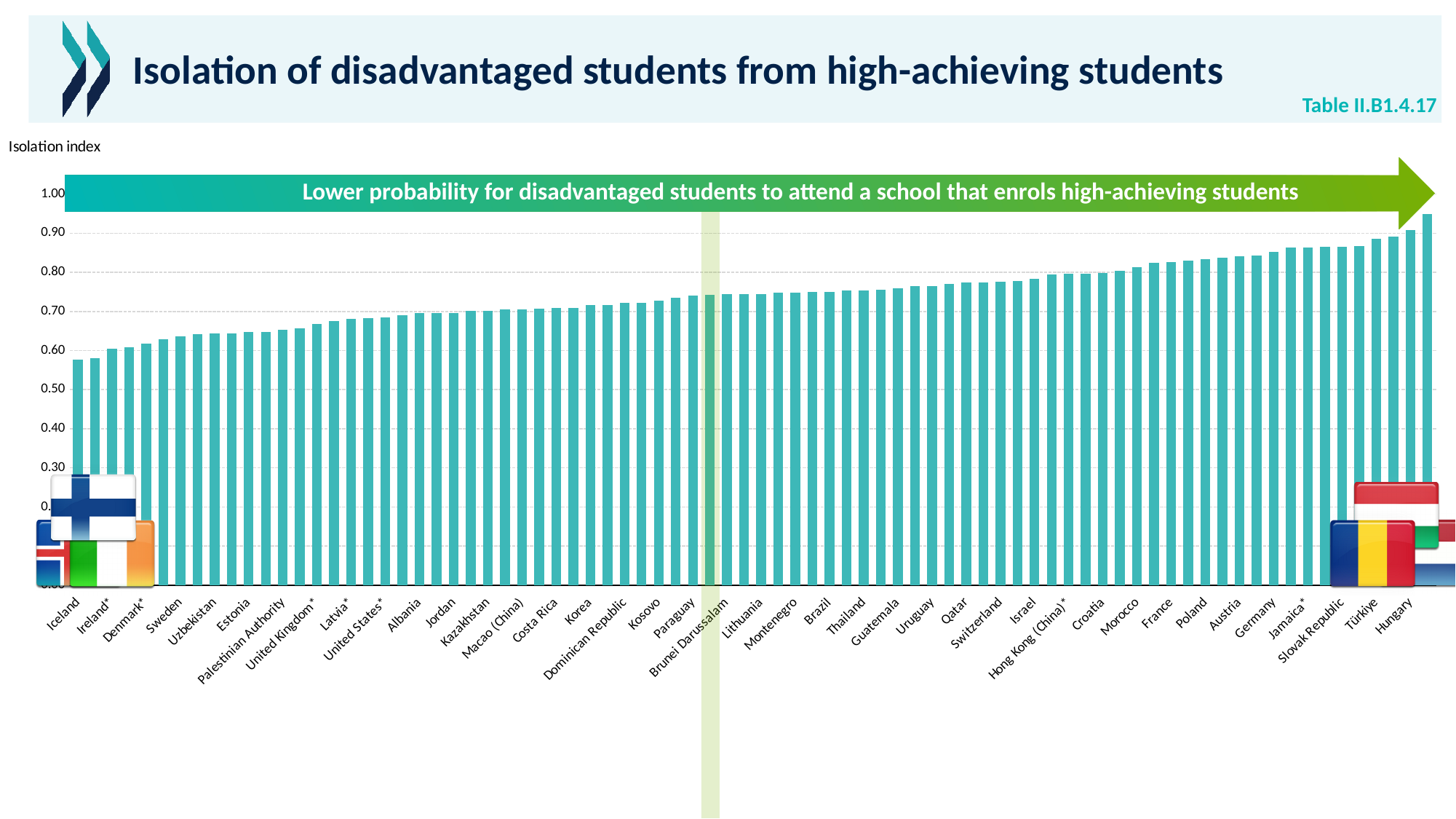
Which labelled country has the highest isolation index? Hungary What kind of chart is shown on the slide? bar chart Is the value for Austria greater or less than 0.80? greater Is the value for Brazil greater or less than 0.70? greater Do the values rise or fall moving from left to right along the x axis? rise Which table is referenced in the top right corner of the slide? Table II.B1.4.17 Is the value for Sweden greater or less than 0.60? greater What is the label of the vertical axis? Isolation index Which has the larger isolation index, Germany or Sweden? Germany Which labelled country has the lowest isolation index? Iceland